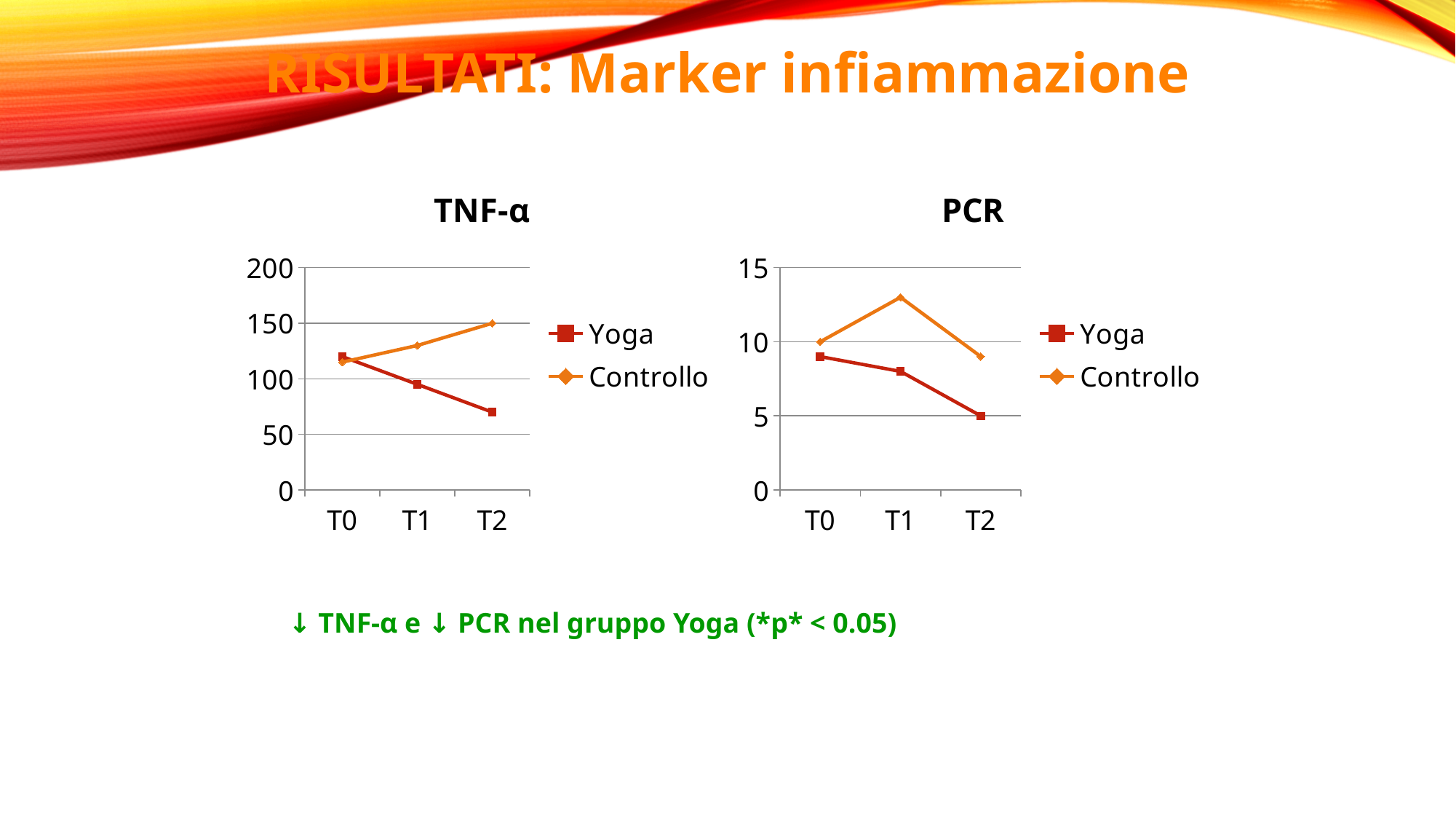
In the TNF-α chart, which series is higher at T2, Yoga or Controllo? Controllo How many series does the legend of the PCR chart list? 2 How many time points are shown on the x axis of the TNF-α chart? 3 What kind of chart is the TNF-α chart? line chart In the PCR chart, is the Controllo value at T1 greater or less than 10? greater In the TNF-α chart, does the Yoga series rise or fall from T0 to T2? fall In the PCR chart, what is the Yoga value at T2? 5 In the TNF-α chart, what is the Controllo value at T2? 150 In the PCR chart, at which time point is the Controllo series highest? T1 In the TNF-α chart, is the Yoga value at T2 greater or less than 100? less In the TNF-α chart, does the Controllo series rise or fall from T0 to T2? rise In the PCR chart, what is the Controllo value at T0? 10